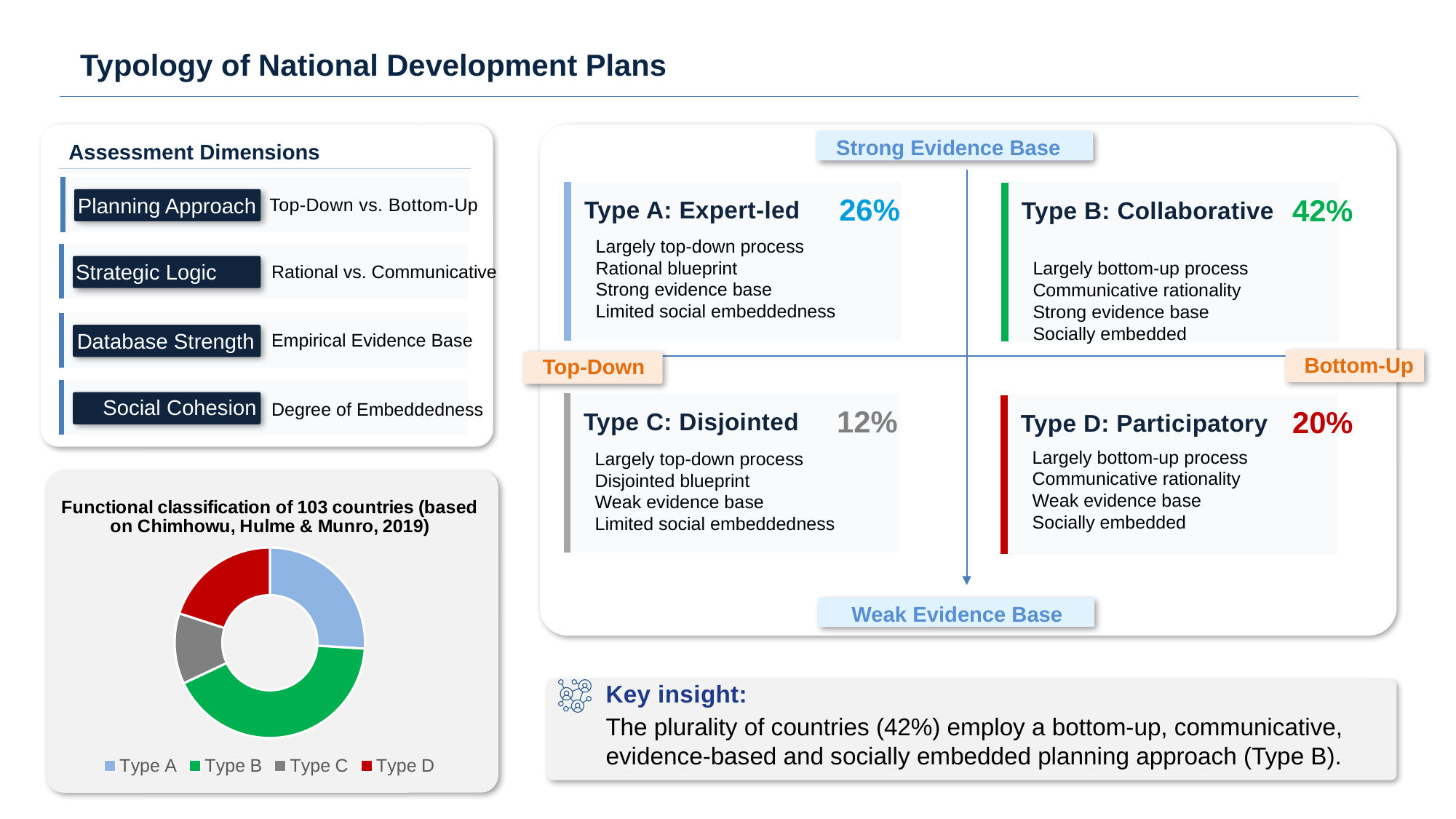
Which slice is larger in the doughnut chart, Type A or Type D? Type A What share of countries does Type A (Expert-led) account for, according to the slide? 26% Which type has the largest slice in the doughnut chart? Type B Which slice is larger in the doughnut chart, Type C or Type D? Type D What share of countries does Type C (Disjointed) account for, according to the slide? 12% What colour represents Type D in the doughnut chart's legend? Red How many slices does the doughnut chart have? 4 What kind of chart is shown on the slide? Doughnut chart What share of countries does Type B (Collaborative) account for, according to the slide? 42% Which type has the smallest slice in the doughnut chart? Type C What is the title of the chart on the slide? Functional classification of 103 countries (based on Chimhowu, Hulme & Munro, 2019) How many categories does the chart's legend list? 4